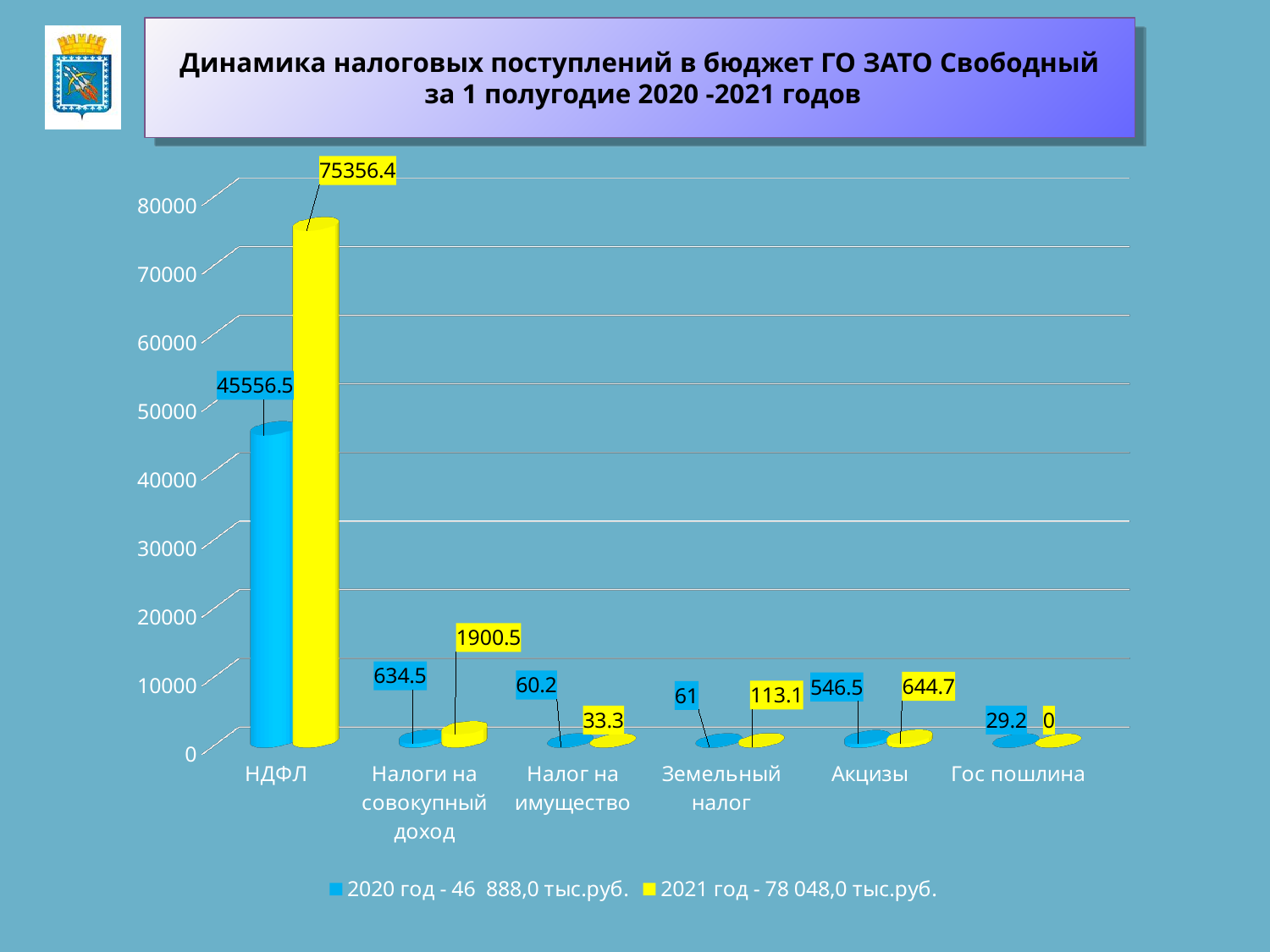
What is the value for НДФЛ in the 2020 год series? 45556.5 What is the value for Гос пошлина in the 2021 год series? 0 Which category has the highest value in the 2021 год series? НДФЛ For Налог на имущество, which series has the larger value, 2020 год or 2021 год? 2020 год What is the value for Акцизы in the 2020 год series? 546.5 How many categories are shown on the x axis? 6 What is the value for Налоги на совокупный доход in the 2021 год series? 1900.5 Which category has the lowest value in the 2020 год series? Гос пошлина What is the value for НДФЛ in the 2021 год series? 75356.4 How many series does the legend list? 2 What type of chart is shown on the slide? Bar chart What is the difference between the 2021 год and 2020 год values for НДФЛ? 29799.9